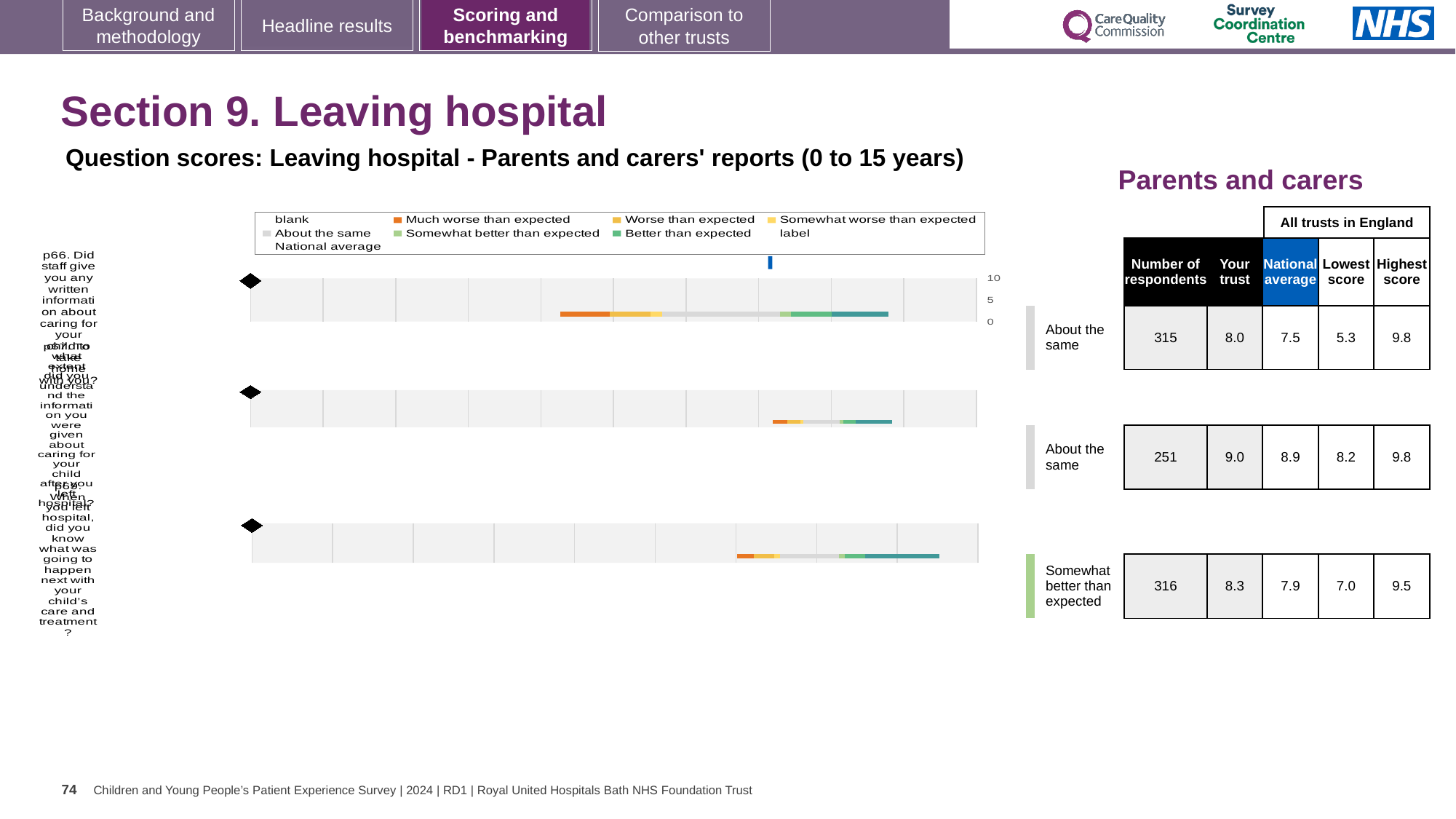
What is the title of the table to the right of the chart? Parents and carers What is the benchmark category shown for the third (bottom) question row? Somewhat better than expected What is the 'Your trust' score for the first (top) question row? 8.0 What is the national average for the second (middle) question row? 8.9 What is the highest score across all trusts in England for the third (bottom) question row? 9.5 Is the 'Your trust' score for the third (bottom) question row higher or lower than its national average? higher What is the number of respondents for the third (bottom) question row? 316 What is the difference between the 'Your trust' score and the national average for the first (top) question row? 0.5 Which question row has the highest 'Your trust' score? the second (middle) row, 9.0 Which question row has the lowest 'Lowest score' value across all trusts in England? the first (top) row, 5.3 How many question rows (bars) are plotted in the chart? 3 What kind of chart is used to show the question scores on this slide? bar chart